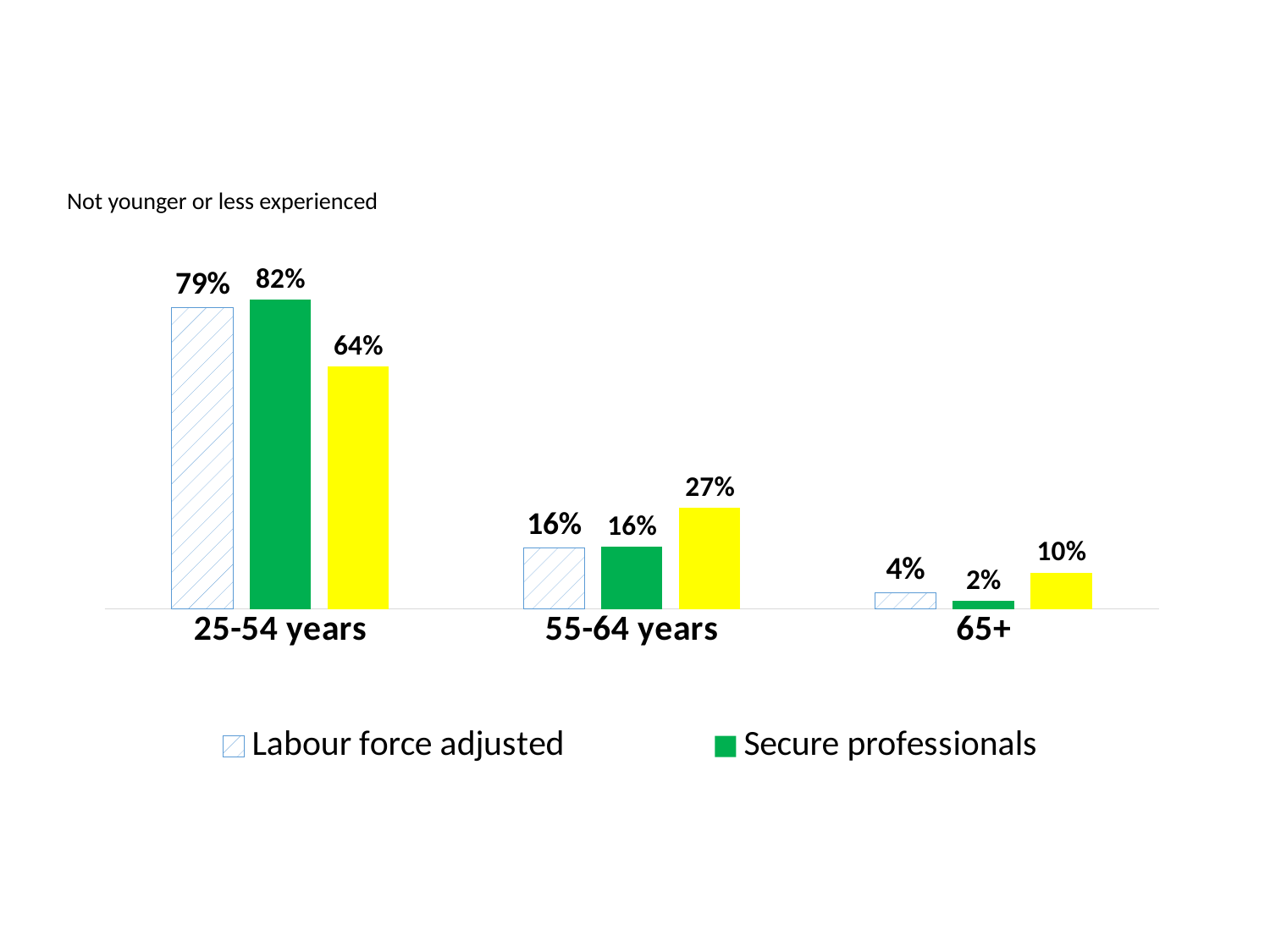
What is the value for Labour force adjusted in the 65+ group? 4% Which age group has the highest value for Secure professionals? 25-54 years What is the value for Secure professionals in the 55-64 years group? 16% Which age group has the lowest value for Labour force adjusted? 65+ In the 25-54 years group, how much higher is Secure professionals than Labour force adjusted? 3 percentage points What is the value for Labour force adjusted in the 25-54 years group? 79% What kind of chart is shown on the slide? Bar chart In the 65+ group, what is the difference between Labour force adjusted and Secure professionals? 2 percentage points How many age groups are shown on the x axis? 3 In the 25-54 years group, which is larger: Labour force adjusted or Secure professionals? Secure professionals What is the value for Secure professionals in the 65+ group? 2% How many series does the legend list? 2